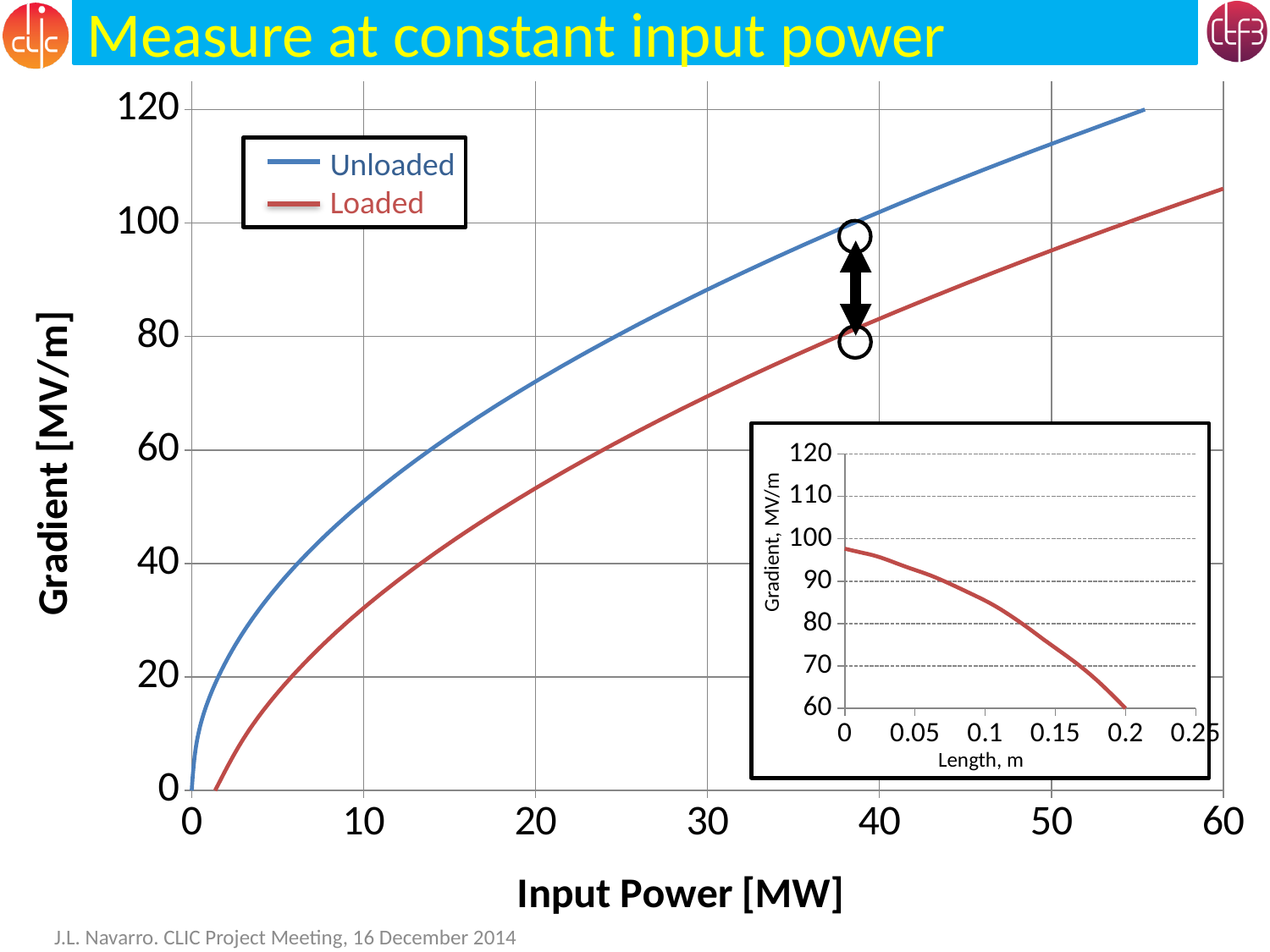
On the main chart, is the Loaded gradient at 20 MW greater or less than 60? less On the inset chart of Gradient against Length, does the gradient rise or fall as Length increases? fall On the main chart, do the Unloaded and Loaded gradients rise or fall as Input Power increases? rise On the main chart, is the Unloaded gradient at 50 MW greater or less than 100? greater On the main chart, is the Loaded gradient at 10 MW greater or less than 40? less On the main chart, how many series does the legend list? 2 On the main chart, at an Input Power of 30 MW, which series has the higher gradient, Unloaded or Loaded? Unloaded On the main chart, what kind of chart is used to show Gradient against Input Power? line chart On the main chart, which series is plotted in blue? Unloaded